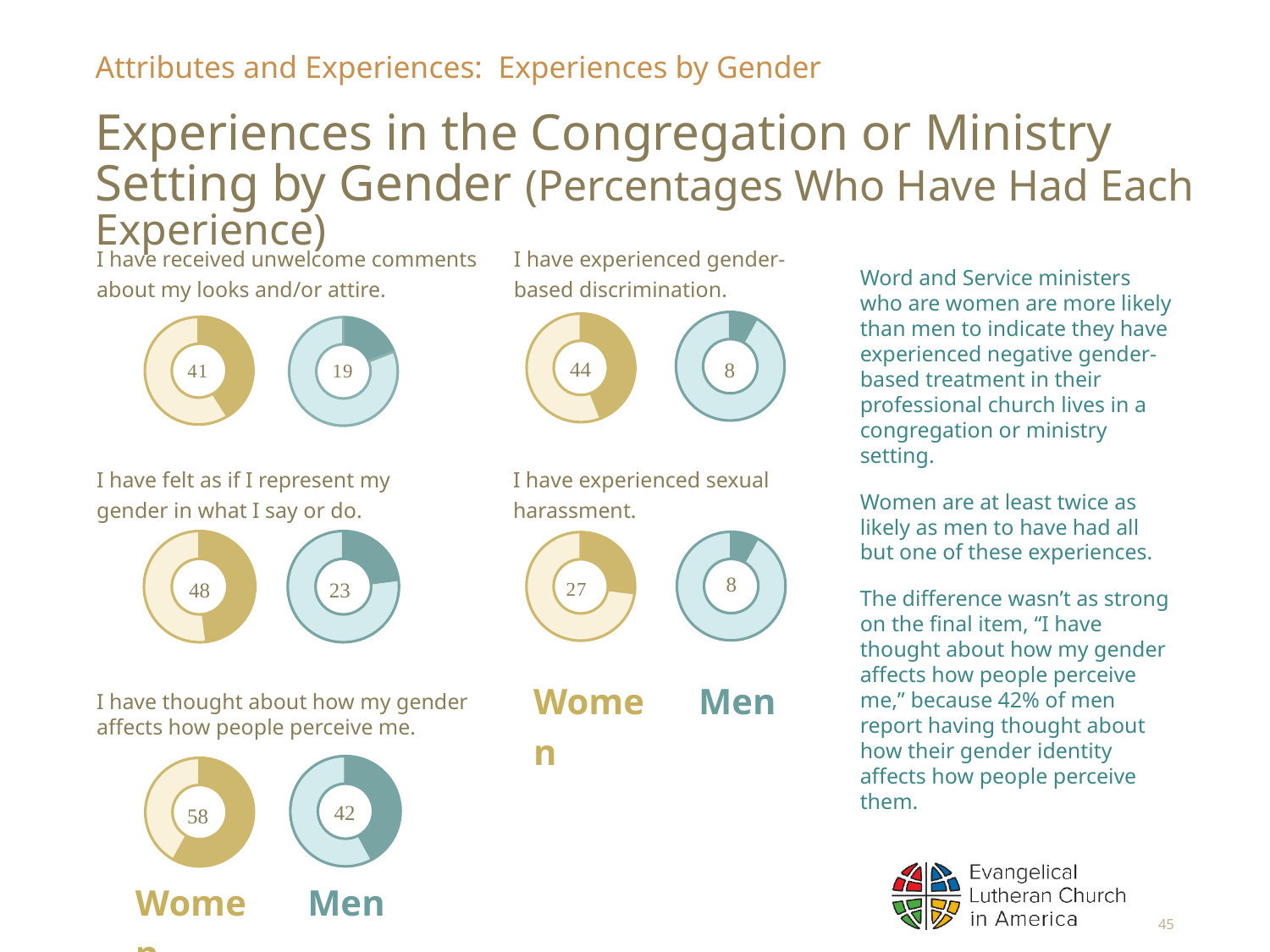
How many experience statements are charted on the slide? 5 In the 'I have thought about how my gender affects how people perceive me' charts, what is the difference between the women's value and the men's value? 16 Across all the women's charts on the slide, which experience has the highest value? I have thought about how my gender affects how people perceive me In the 'I have received unwelcome comments about my looks and/or attire' charts, what percentage of women have had this experience? 41 In the 'I have received unwelcome comments about my looks and/or attire' charts, what percentage of men have had this experience? 19 In the 'I have experienced sexual harassment' charts, what value is shown for women? 27 Across all the men's charts on the slide, which experience has the lowest value? I have experienced gender-based discrimination and I have experienced sexual harassment (both 8) In the 'I have thought about how my gender affects how people perceive me' charts, which group has the higher value, women or men? Women What kind of chart is used to show each value on the slide? Donut (pie) chart In the 'I have felt as if I represent my gender in what I say or do' charts, what is the difference between the women's value and the men's value? 25 In the 'I have experienced gender-based discrimination' charts, what value is shown for women? 44 In the 'I have experienced gender-based discrimination' charts, what value is shown for men? 8